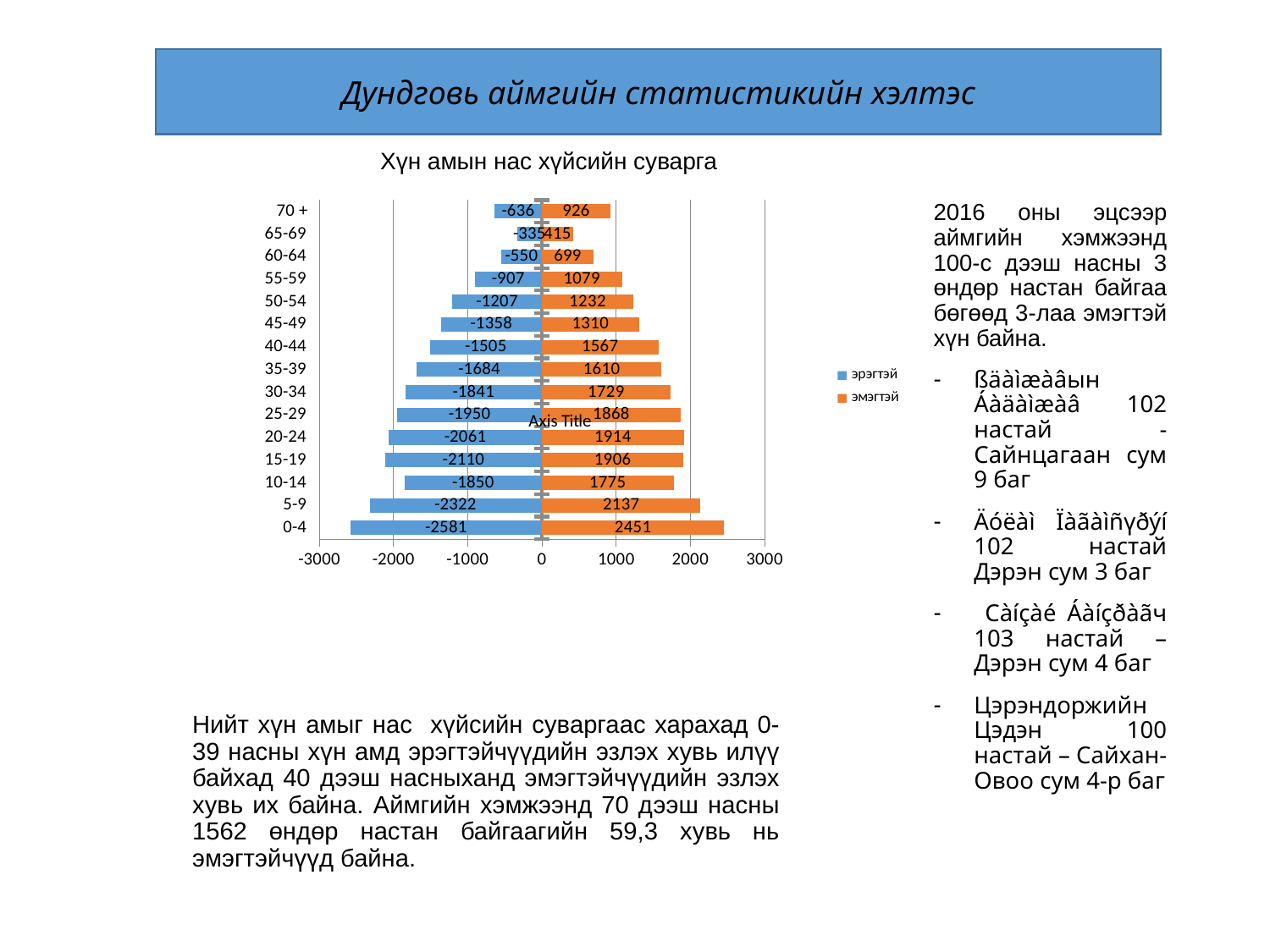
Which is larger, the эмэгтэй value for 20-24 or for 15-19? 20-24 What is the value for эмэгтэй in the 0-4 age group? 2451 Which age group has the highest эмэгтэй value? 0-4 What is the value for эрэгтэй in the 0-4 age group, as printed on the chart? -2581 What is the value for эрэгтэй in the 55-59 age group, as printed on the chart? -907 What is the value for эмэгтэй in the 70 + age group? 926 Which age group has the lowest эмэгтэй value? 65-69 What is the difference between the эмэгтэй values for the 0-4 and 5-9 age groups? 314 What kind of chart is shown on the slide? bar chart What is the title of the chart? Хүн амын нас хүйсийн суварга How many age groups are shown on the chart? 15 How many series does the legend list? 2